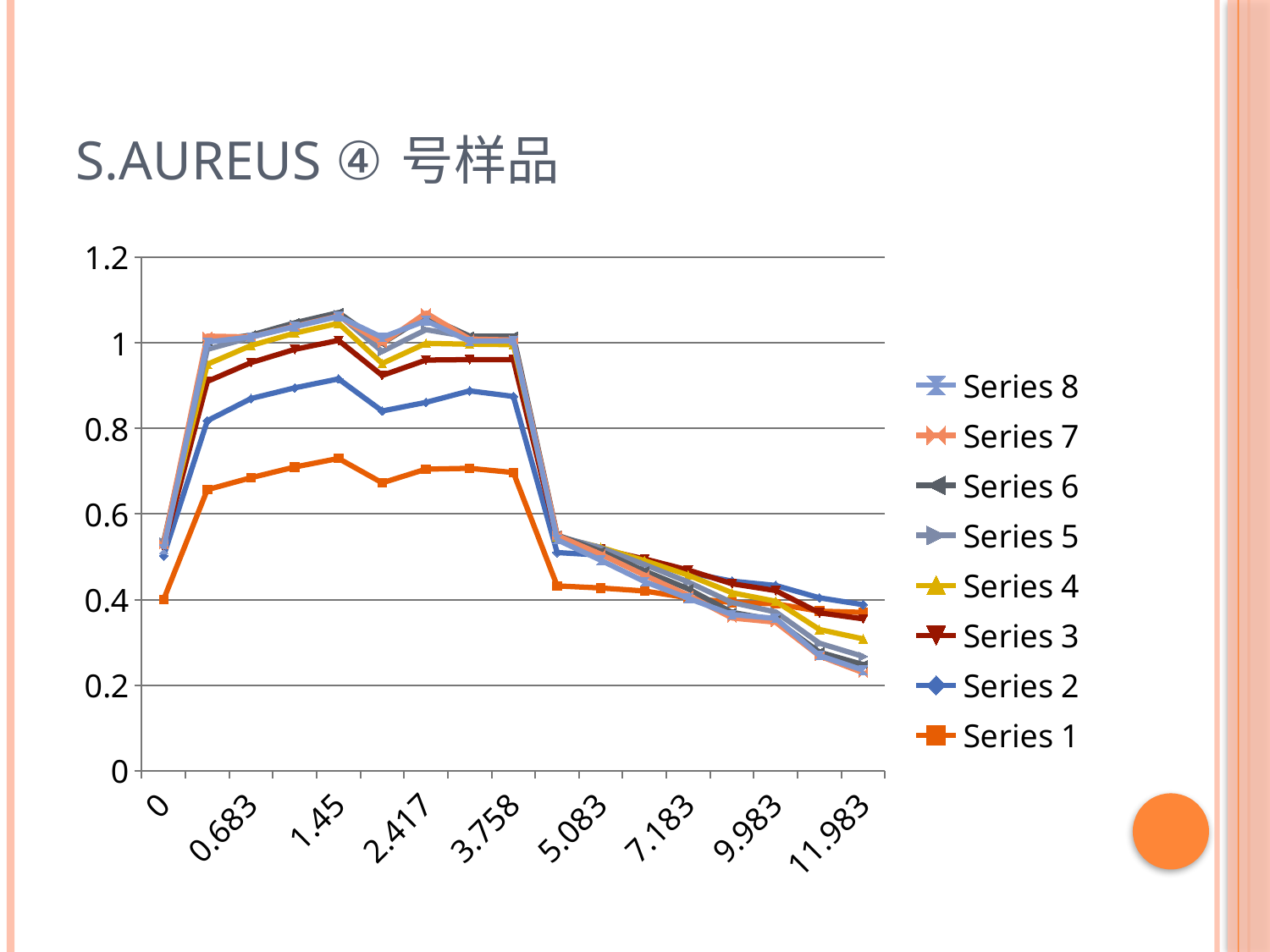
Do the values for Series 1 rise or fall from x = 5.083 to x = 11.983? fall Is the value for Series 2 at x = 0.683 greater or less than 0.8? greater How many series does the legend list? 8 Is the value for Series 3 at x = 5.083 greater or less than 0.6? less Which series is listed at the top of the legend? Series 8 What is the title of the chart on the slide? S.AUREUS ④ 号样品 At x = 0, which series has the lowest value? Series 1 What kind of chart is shown on the slide? line chart Is the value for Series 7 at x = 11.983 greater or less than 0.4? less At x = 2.417, which is larger: Series 2 or Series 1? Series 2 At x = 1.45, which is larger: Series 1 or Series 3? Series 3